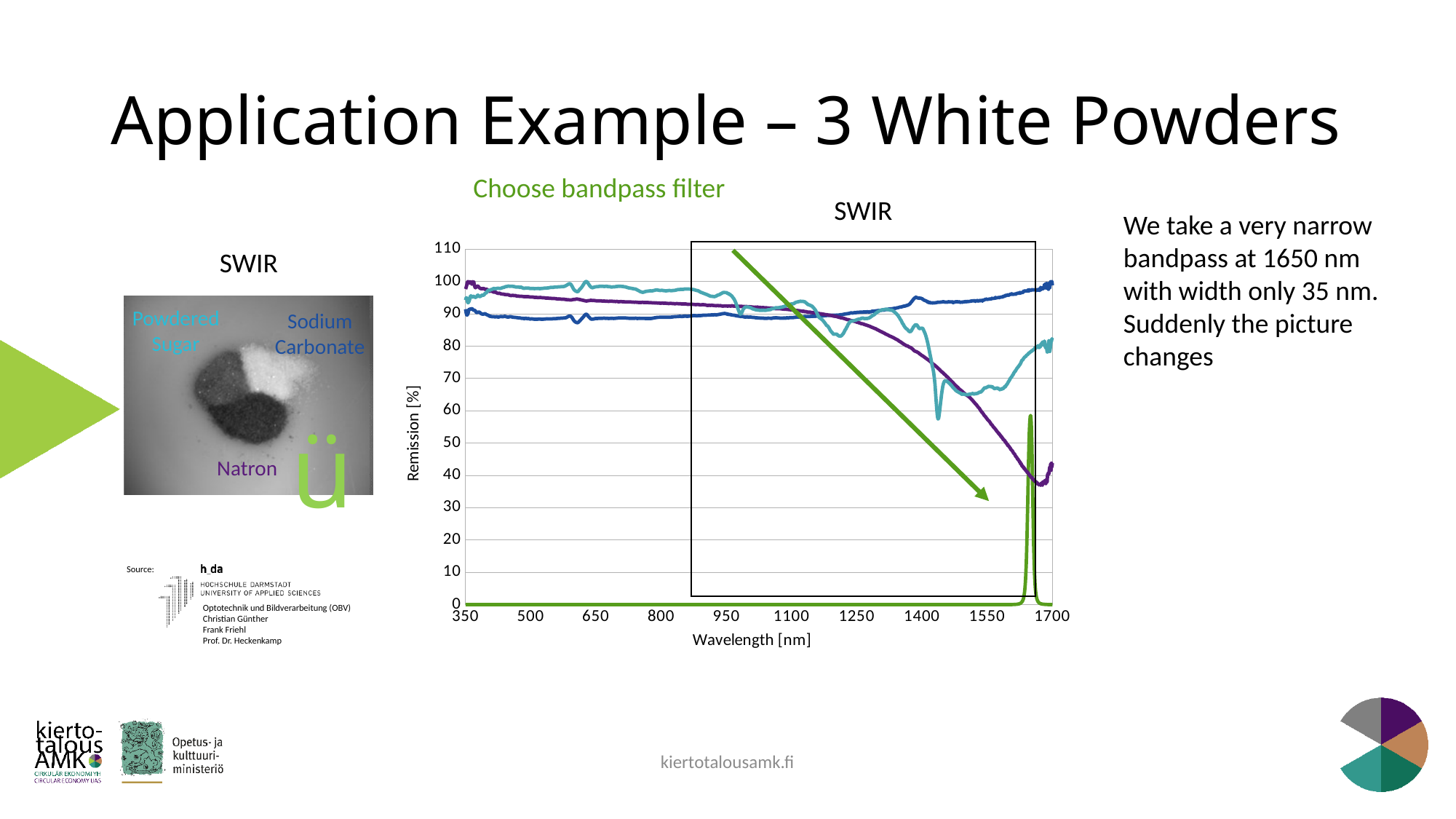
Is the value of the purple line at 1700 nm greater or less than 50? less What is the highest value shown on the y axis of the line chart? 110 What is the lowest wavelength shown on the x axis of the line chart? 350 What is the highest wavelength shown on the x axis of the line chart? 1700 Does the purple line in the chart rise or fall overall as wavelength increases from 350 to 1700 nm? fall What is the label of the y axis of the line chart? Remission [%] At 1700 nm, which line has the larger remission value, the dark blue line or the purple line? the dark blue line What kind of chart is shown in the middle of the slide? line chart Is the value of the dark blue line at 1700 nm greater or less than 90? greater What is the label of the x axis of the line chart? Wavelength [nm] Is the lowest point of the light blue line (near 1450 nm) greater or less than 70? less